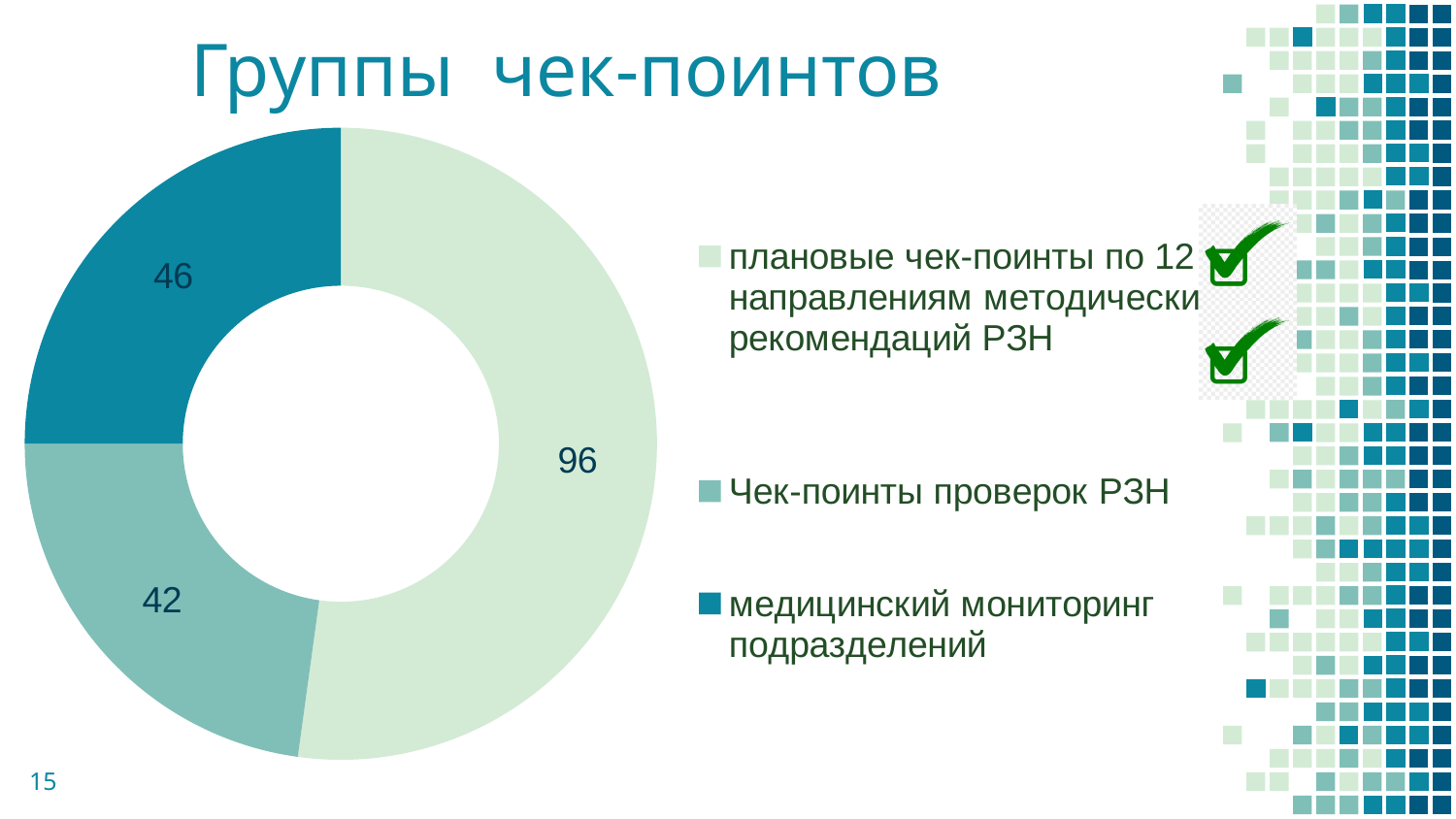
What is the value for «медицинский мониторинг подразделений»? 46 What kind of chart is shown on the slide? doughnut (pie) chart Which category has the largest slice? плановые чек-поинты по 12 направлениям методических рекомендаций РЗН What is the value for «Чек-поинты проверок РЗН»? 42 Which category has the smallest slice? Чек-поинты проверок РЗН What share of the total does «медицинский мониторинг подразделений» represent? 25% How many categories does the chart show? 3 Which is larger: the value for «медицинский мониторинг подразделений» or the value for «Чек-поинты проверок РЗН»? медицинский мониторинг подразделений What is the total of all slices in the chart? 184 What is the difference between the value for «плановые чек-поинты по 12 направлениям методических рекомендаций РЗН» and the value for «медицинский мониторинг подразделений»? 50 What is the value for «плановые чек-поинты по 12 направлениям методических рекомендаций РЗН»? 96 What is the difference between the value for «медицинский мониторинг подразделений» and the value for «Чек-поинты проверок РЗН»? 4